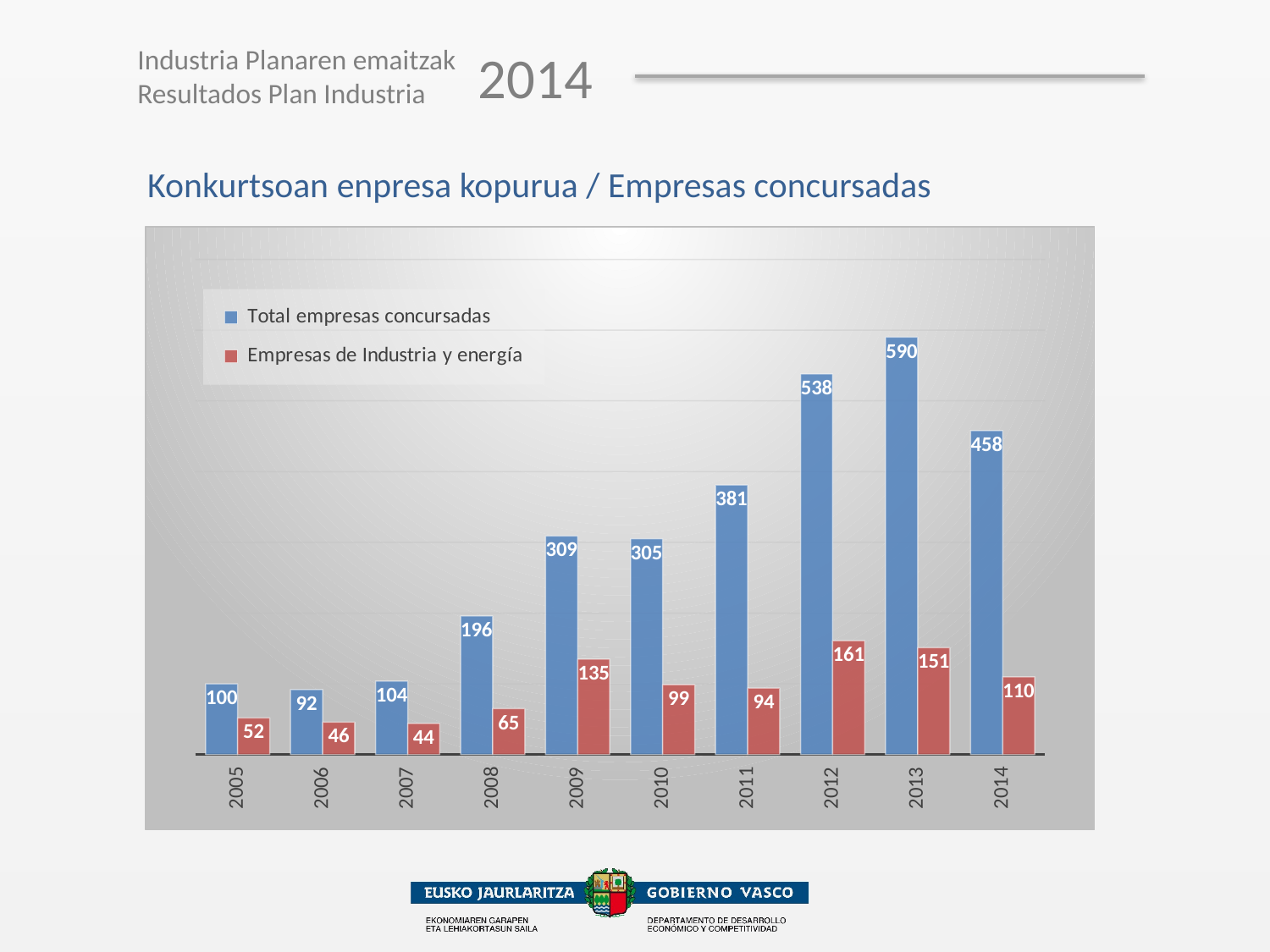
Which is larger: Empresas de Industria y energía in 2012 or in 2013? 2012 What is the value of Total empresas concursadas for 2012? 538 How many series does the legend list? 2 What kind of chart is shown on the slide? Bar chart Which year has the lowest value for Empresas de Industria y energía? 2007 Does Total empresas concursadas rise or fall from 2010 to 2013? Rise How many years are shown on the x axis? 10 What is the difference between Total empresas concursadas and Empresas de Industria y energía in 2014? 348 Which colour represents Empresas de Industria y energía in the chart? Red What is the value of Empresas de Industria y energía for 2009? 135 What is the value of Total empresas concursadas for 2006? 92 Which year has the highest value for Total empresas concursadas? 2013